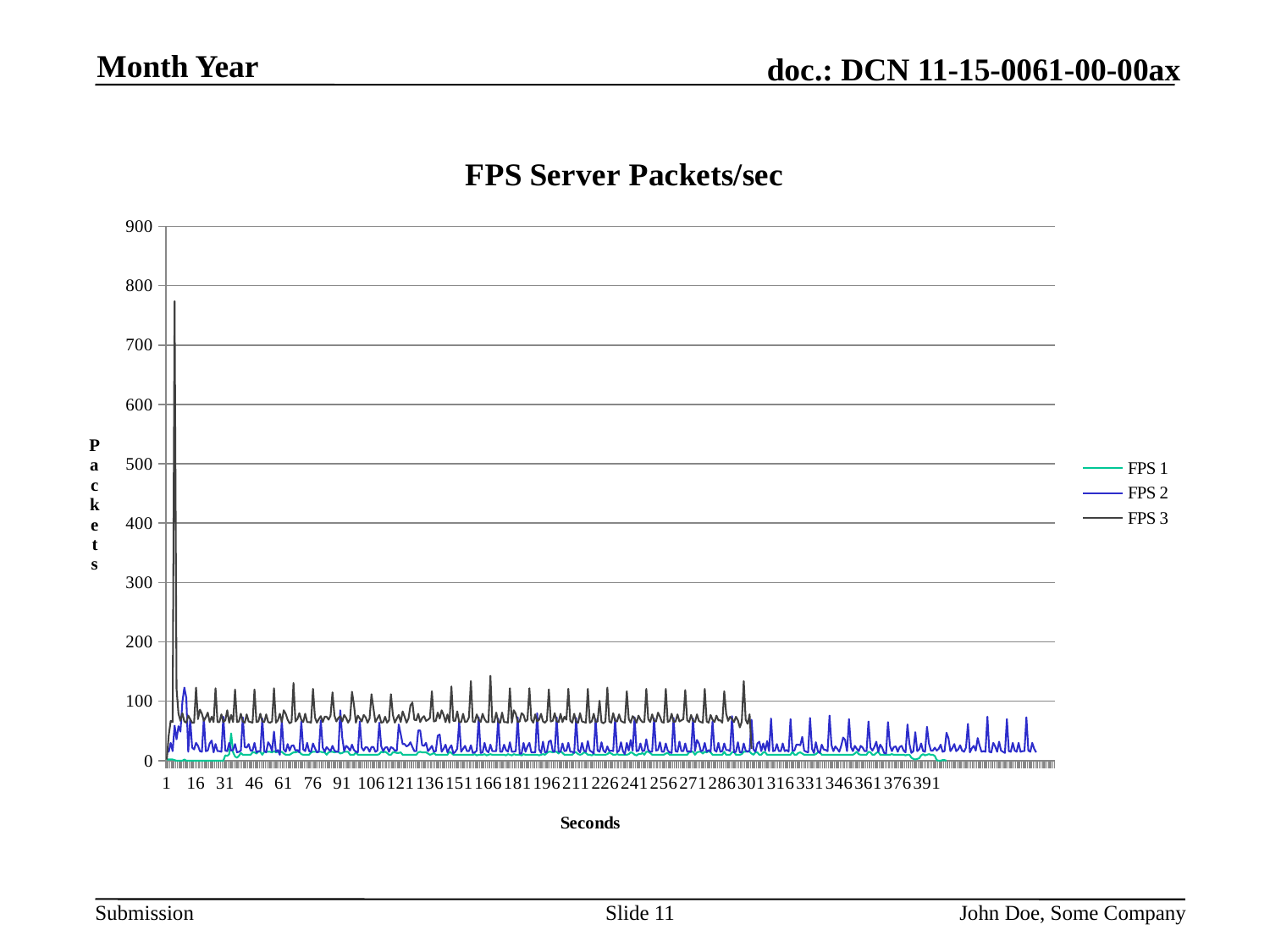
What is the highest value shown on the vertical axis? 900 Is the highest peak of the FPS 3 series greater or less than 700? greater Which series has the higher peak value, FPS 2 or FPS 3? FPS 3 Is the highest peak of the FPS 2 series greater or less than 200? less What kind of chart is shown on the slide? Line chart How many series does the legend list? 3 Which series reaches the highest peak value on the chart? FPS 3 Which series generally stays lowest across the chart? FPS 1 What is the title of the chart? FPS Server Packets/sec What is the label of the horizontal axis? Seconds Is the highest peak of the FPS 3 series greater or less than 800? less Does the FPS 3 series continue to the right end of the x axis, or does it stop before the FPS 2 series ends? It stops before the FPS 2 series ends